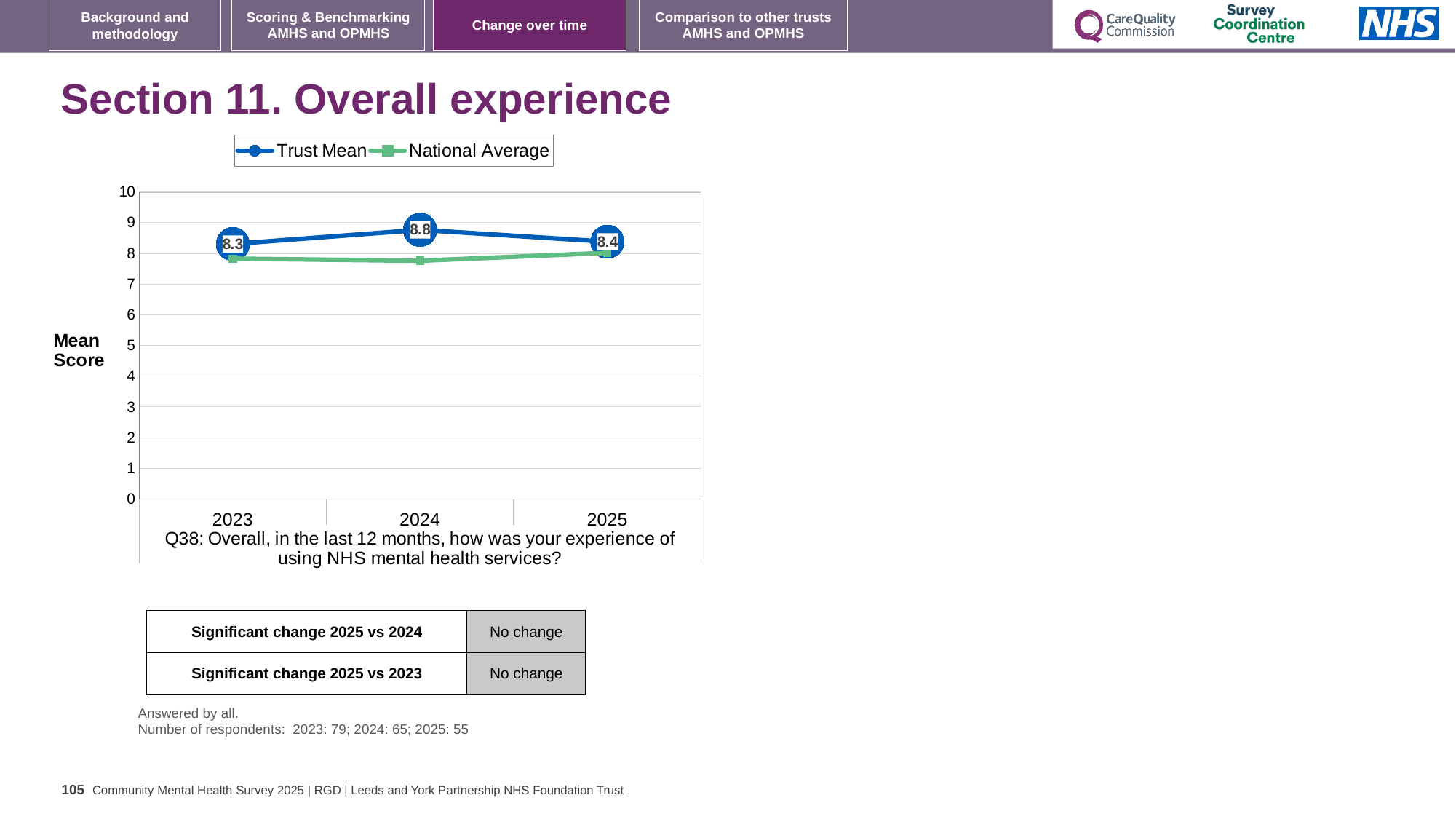
What is the difference between the Trust Mean in 2024 and in 2023? 0.5 How many series does the legend list? 2 Does the Trust Mean rise or fall from 2024 to 2025? fall In which year is the Trust Mean highest? 2024 What is the Trust Mean for 2023? 8.3 Is the National Average for 2023 greater or less than 9? less In which year is the Trust Mean lowest? 2023 What kind of chart is shown? line chart In 2024, which is larger: the Trust Mean or the National Average? Trust Mean What is the Trust Mean for 2024? 8.8 How many years are shown on the x axis? 3 What is the Trust Mean for 2025? 8.4